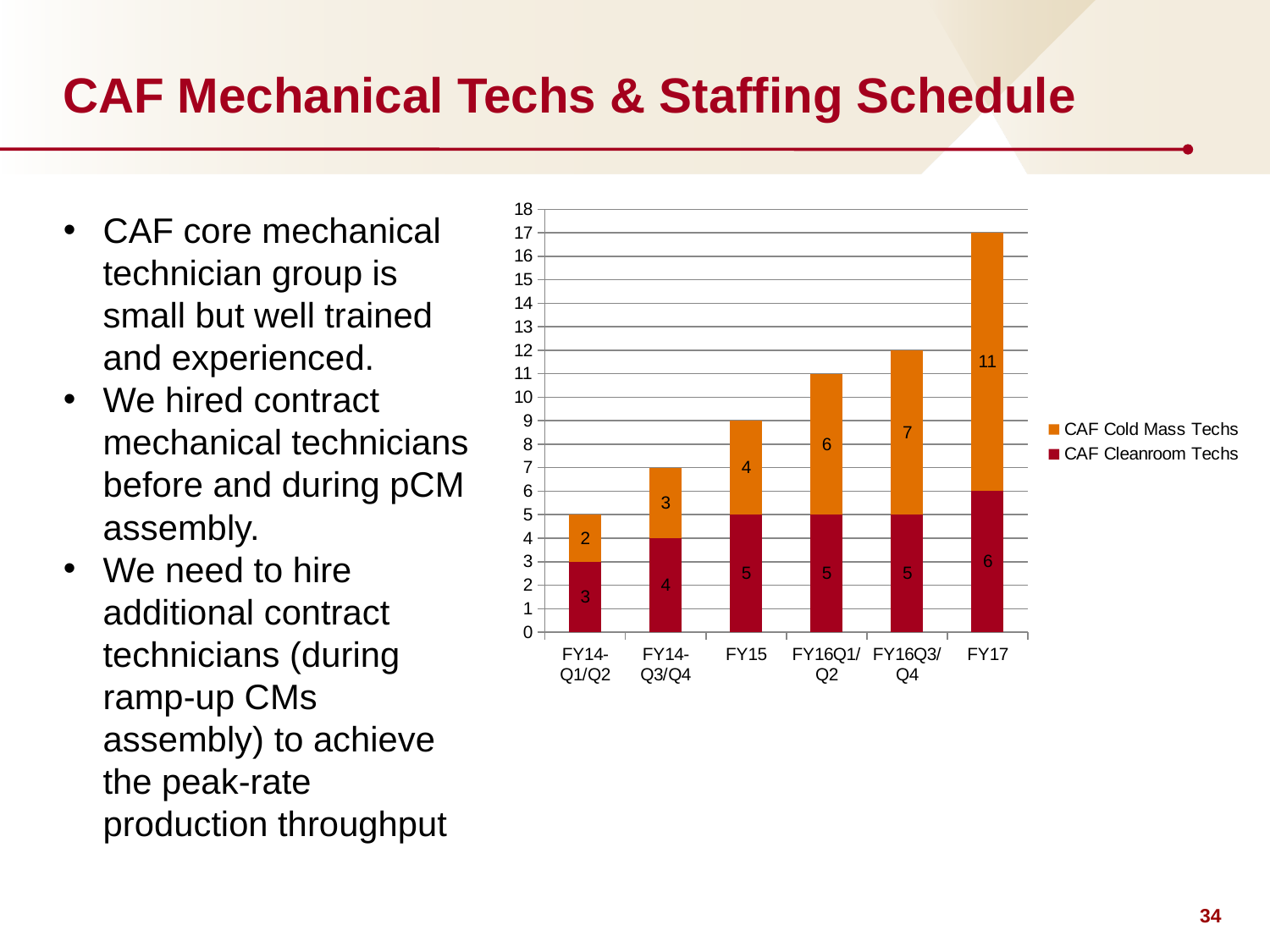
What is the value for CAF Cold Mass Techs in FY16Q3/Q4? 7 Which category has the highest value for CAF Cold Mass Techs? FY17 What is the difference between CAF Cold Mass Techs in FY17 and in FY15? 7 Which is larger: CAF Cold Mass Techs in FY16Q1/Q2 or CAF Cleanroom Techs in FY16Q1/Q2? CAF Cold Mass Techs What is the value for CAF Cleanroom Techs in FY14-Q3/Q4? 4 Which category has the lowest value for CAF Cleanroom Techs? FY14-Q1/Q2 Do the total stacked bar values rise or fall from FY14-Q1/Q2 to FY17? Rise What kind of chart is shown on the slide? Stacked bar chart What is the value for CAF Cold Mass Techs in FY17? 11 How many series does the legend list? 2 What is the total of the stacked bar for FY16Q1/Q2? 11 How many categories are shown on the x axis? 6